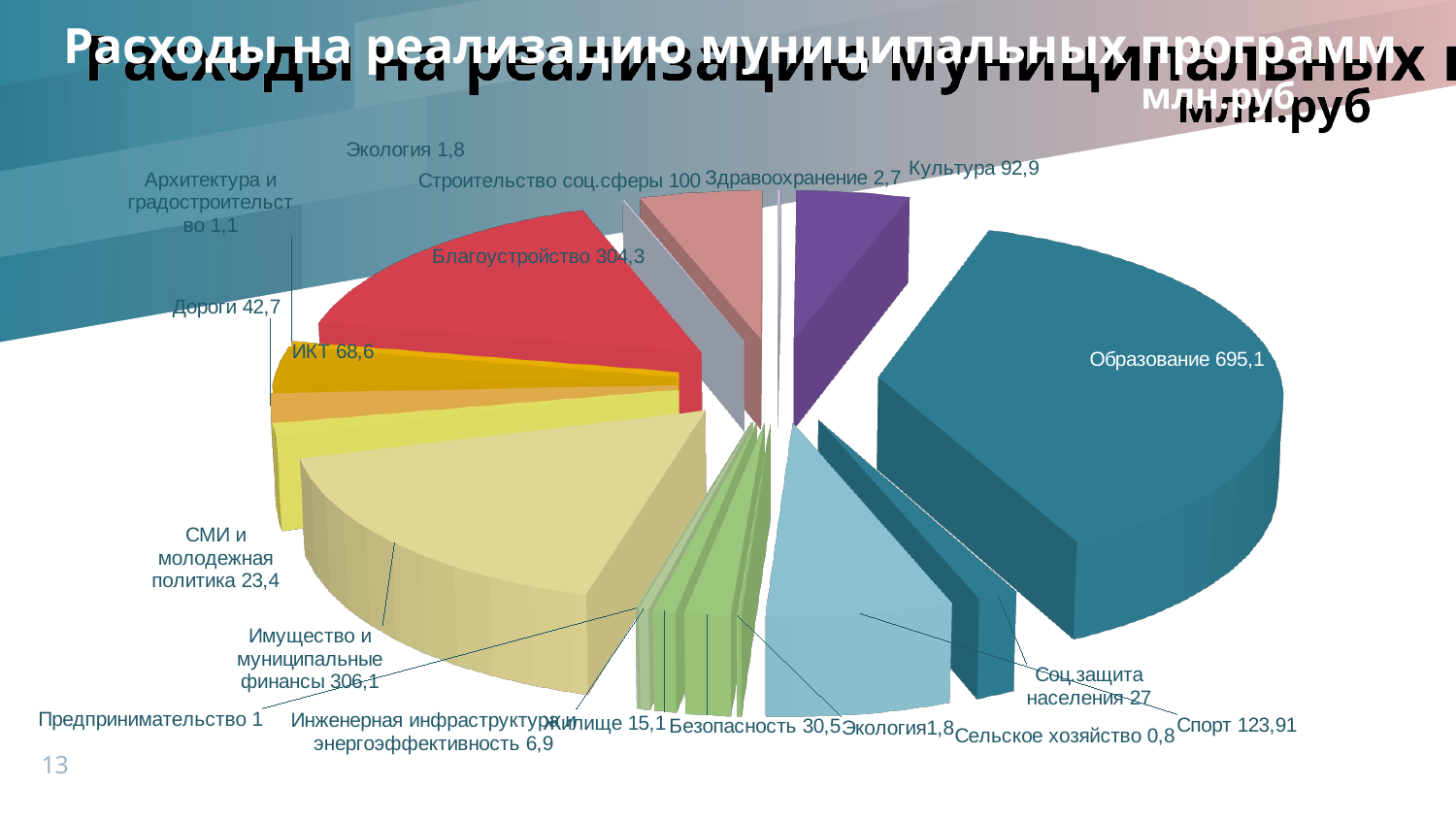
In what unit are the values on the chart given? млн.руб What is the value for Соц.защита населения? 27 What is the difference between Имущество и муниципальные финансы and Благоустройство? 1,8 Which is larger, Спорт or Культура? Спорт What is the difference between Строительство соц.сферы and Культура? 7,1 What is the value for Образование? 695,1 What kind of chart is shown on the slide? pie chart What is the value for Благоустройство? 304,3 What is the value for Спорт? 123,91 Which category has the lowest value? Сельское хозяйство What is the value for Сельское хозяйство? 0,8 Which category has the highest value? Образование